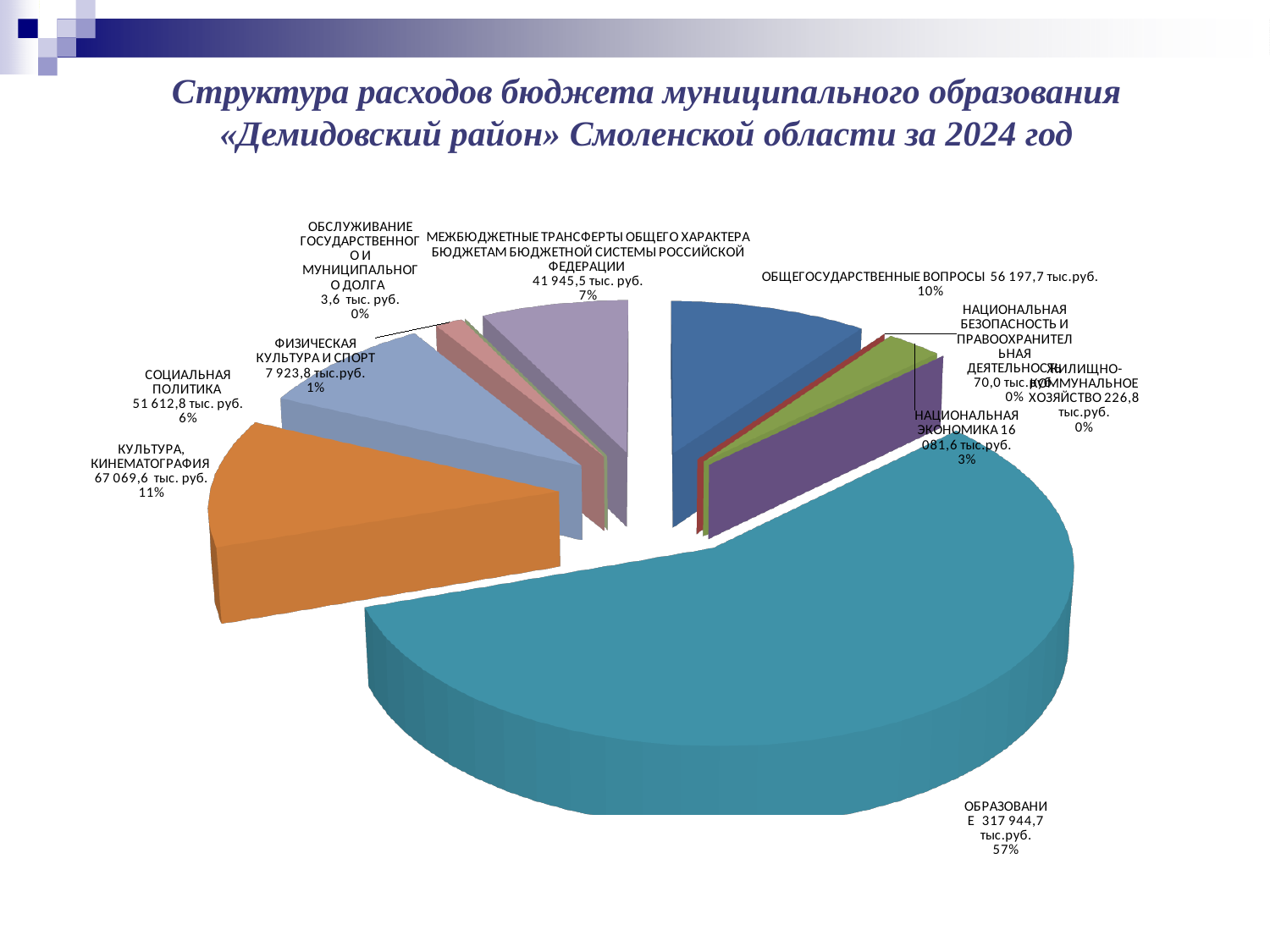
What kind of chart is shown on the slide? Pie chart What is the value for СОЦИАЛЬНАЯ ПОЛИТИКА? 51 612,8 тыс. руб. Which category has the smallest value? ОБСЛУЖИВАНИЕ ГОСУДАРСТВЕННОГО И МУНИЦИПАЛЬНОГО ДОЛГА What is the value for ОБРАЗОВАНИЕ? 317 944,7 тыс.руб. What is the value for КУЛЬТУРА, КИНЕМАТОГРАФИЯ? 67 069,6 тыс. руб. How many categories does the pie chart show? 10 What share of the pie does ОБРАЗОВАНИЕ take? 57% What share of the pie does ОБЩЕГОСУДАРСТВЕННЫЕ ВОПРОСЫ take? 10% What share of the pie does МЕЖБЮДЖЕТНЫЕ ТРАНСФЕРТЫ ОБЩЕГО ХАРАКТЕРА БЮДЖЕТАМ БЮДЖЕТНОЙ СИСТЕМЫ РОССИЙСКОЙ ФЕДЕРАЦИИ take? 7% Which is larger, КУЛЬТУРА, КИНЕМАТОГРАФИЯ or СОЦИАЛЬНАЯ ПОЛИТИКА? КУЛЬТУРА, КИНЕМАТОГРАФИЯ Which category has the largest slice of the pie? ОБРАЗОВАНИЕ What is the difference between the values for ОБЩЕГОСУДАРСТВЕННЫЕ ВОПРОСЫ and СОЦИАЛЬНАЯ ПОЛИТИКА? 4 584,9 тыс. руб.